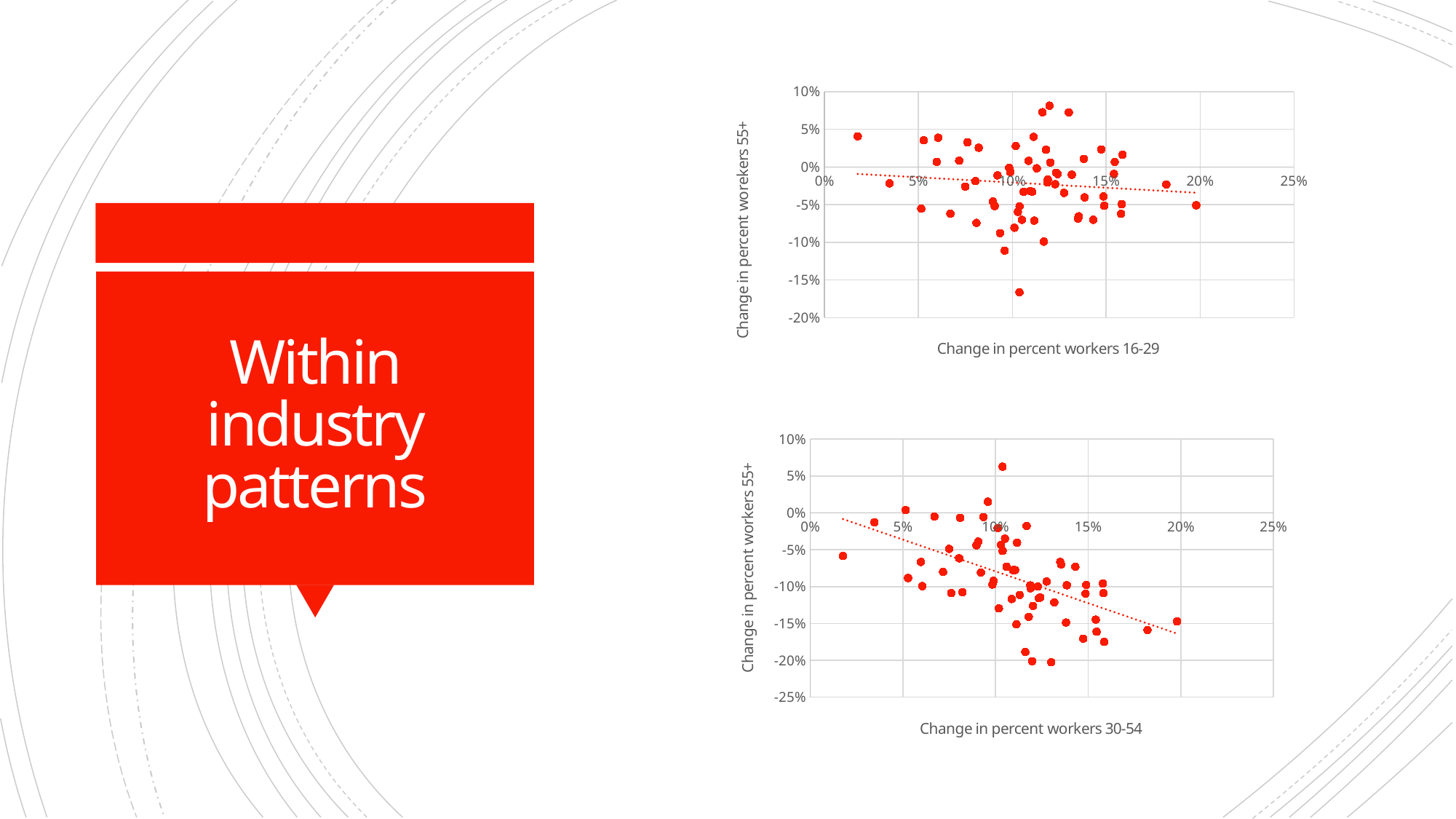
Which chart shows the steeper downward trend line, the top chart or the bottom chart? The bottom chart In the bottom chart, does the dotted trend line rise or fall as the change in percent workers 30-54 increases? Falls In the top chart, is the lowest plotted point greater or less than -15% on the vertical axis? less In the bottom chart, what is the title of the horizontal axis? Change in percent workers 30-54 What kind of chart is the bottom chart on the slide? Scatter chart In the bottom chart, is the highest plotted point greater or less than 5% on the vertical axis? greater In the top chart, what is the title of the horizontal axis? Change in percent workers 16-29 What is the lowest value shown on the vertical axis of the bottom chart? -25% In the top chart, does the dotted trend line rise or fall as the change in percent workers 16-29 increases? Falls What kind of chart is the top chart on the slide? Scatter chart In the top chart, is the highest plotted point greater or less than 5% on the vertical axis? greater